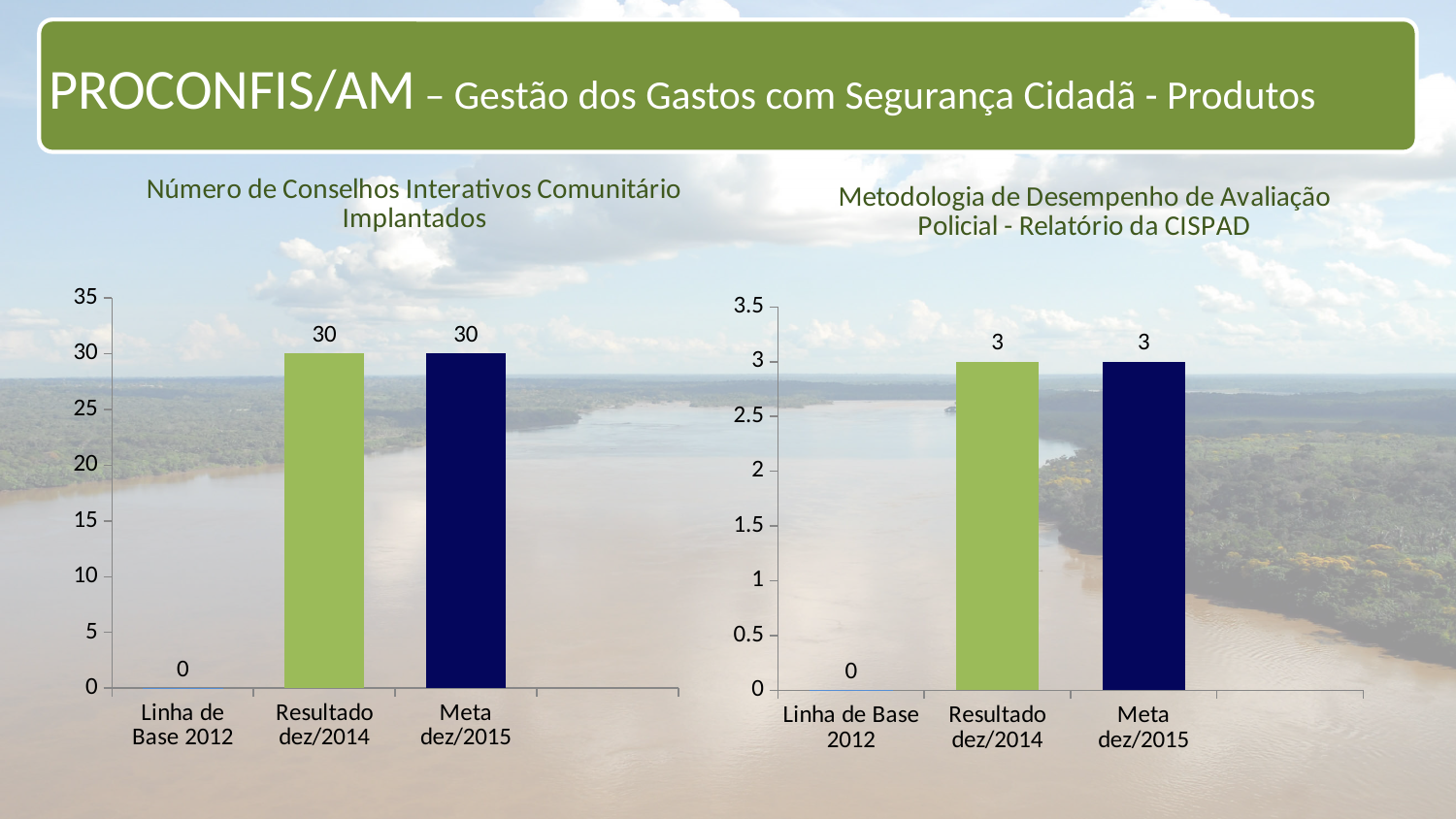
In the chart 'Número de Conselhos Interativos Comunitário Implantados', what is the difference between Meta dez/2015 and Linha de Base 2012? 30 In the chart 'Metodologia de Desempenho de Avaliação Policial - Relatório da CISPAD', which is larger, Resultado dez/2014 or Linha de Base 2012? Resultado dez/2014 In the chart 'Número de Conselhos Interativos Comunitário Implantados', what is the value for Resultado dez/2014? 30 In the chart 'Número de Conselhos Interativos Comunitário Implantados', what is the value for Linha de Base 2012? 0 What kind of chart is 'Metodologia de Desempenho de Avaliação Policial - Relatório da CISPAD'? Bar chart How many charts are shown on the slide? 2 In the chart 'Metodologia de Desempenho de Avaliação Policial - Relatório da CISPAD', what is the value for Linha de Base 2012? 0 In the chart 'Número de Conselhos Interativos Comunitário Implantados', is the value for Resultado dez/2014 greater or less than 25? greater In the chart 'Número de Conselhos Interativos Comunitário Implantados', which category has the lowest value? Linha de Base 2012 In the chart 'Metodologia de Desempenho de Avaliação Policial - Relatório da CISPAD', what is the value for Meta dez/2015? 3 In the chart 'Metodologia de Desempenho de Avaliação Policial - Relatório da CISPAD', what is the difference between Resultado dez/2014 and Meta dez/2015? 0 How many categories are shown in the chart 'Número de Conselhos Interativos Comunitário Implantados'? 3